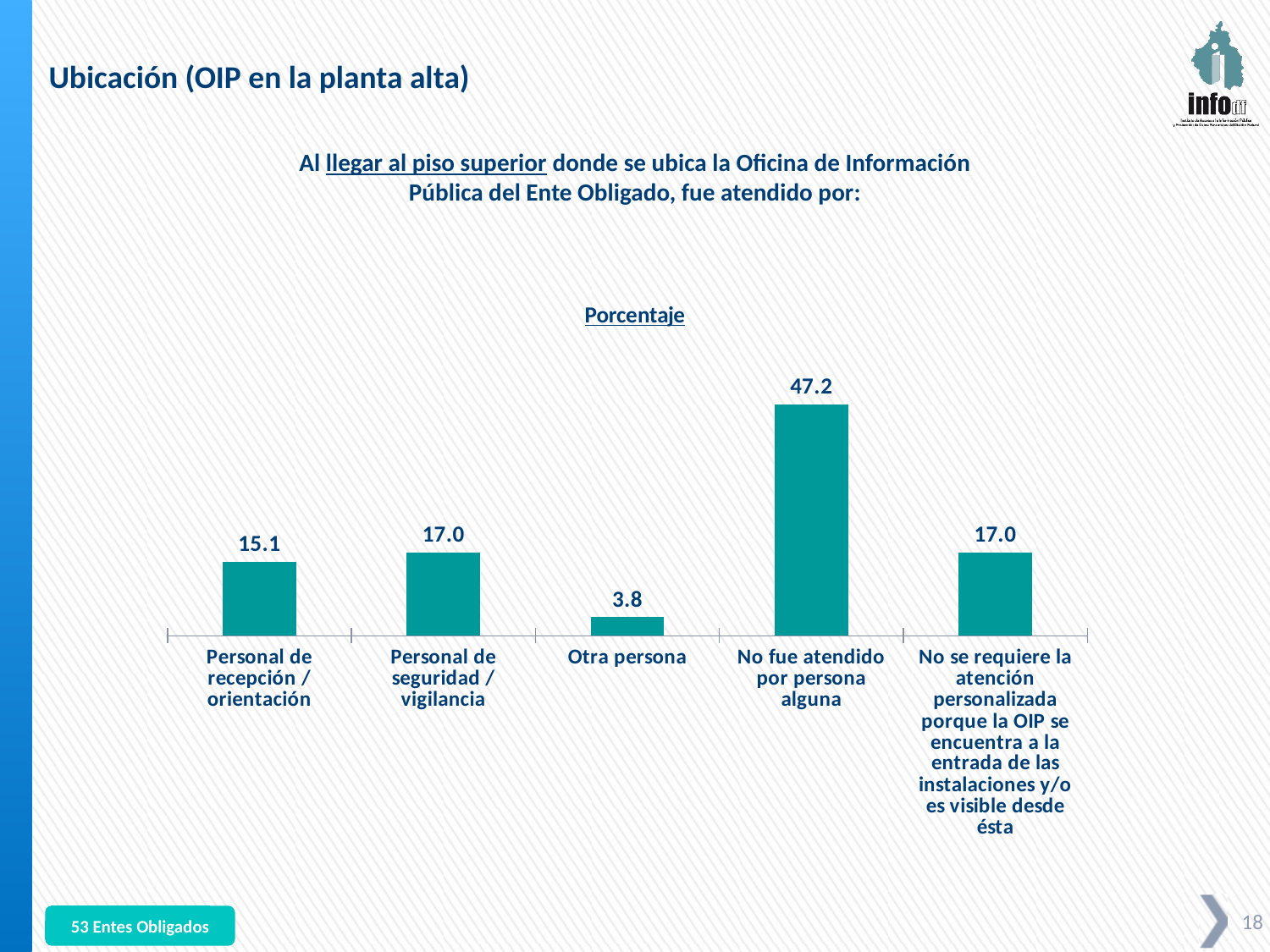
How many categories are shown on the chart? 5 Which category has the lowest value? Otra persona What is the difference between the values for "No fue atendido por persona alguna" and "Personal de seguridad / vigilancia"? 30.2 Which two categories share the same value of 17.0? Personal de seguridad / vigilancia and No se requiere la atención personalizada porque la OIP se encuentra a la entrada de las instalaciones y/o es visible desde ésta What is the title of the chart? Porcentaje What is the difference between the values for "Personal de recepción / orientación" and "Otra persona"? 11.3 What is the value for "No fue atendido por persona alguna"? 47.2 What is the value for "Personal de recepción / orientación"? 15.1 Which category has the highest value? No fue atendido por persona alguna What kind of chart is shown on the slide? Bar chart Which is larger, the value for "Personal de seguridad / vigilancia" or the value for "Personal de recepción / orientación"? Personal de seguridad / vigilancia What is the value for "Otra persona"? 3.8